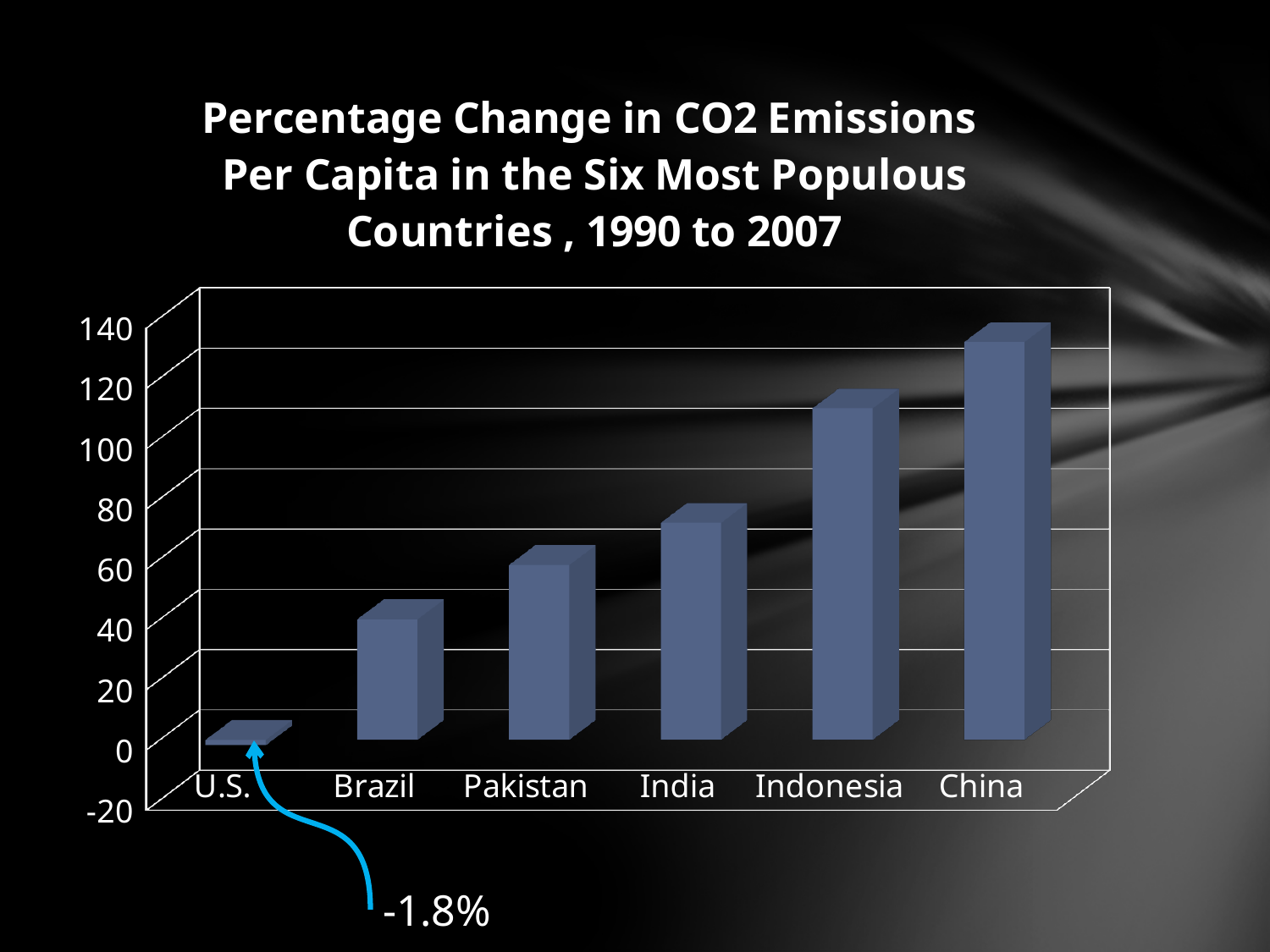
Which has a larger value, Brazil or Pakistan? Pakistan Which country has the highest percentage change in CO2 emissions per capita? China Is the value for China greater or less than 120? greater Is the value for India greater or less than 80? less Which country has the lowest percentage change in CO2 emissions per capita? U.S. Which has a larger value, Indonesia or India? Indonesia What kind of chart is shown on the slide? Bar chart Is the value for Indonesia greater or less than 100? greater What is the value shown for the U.S.? -1.8% Do the values rise or fall from left to right across the countries? Rise How many countries are shown in the chart? 6